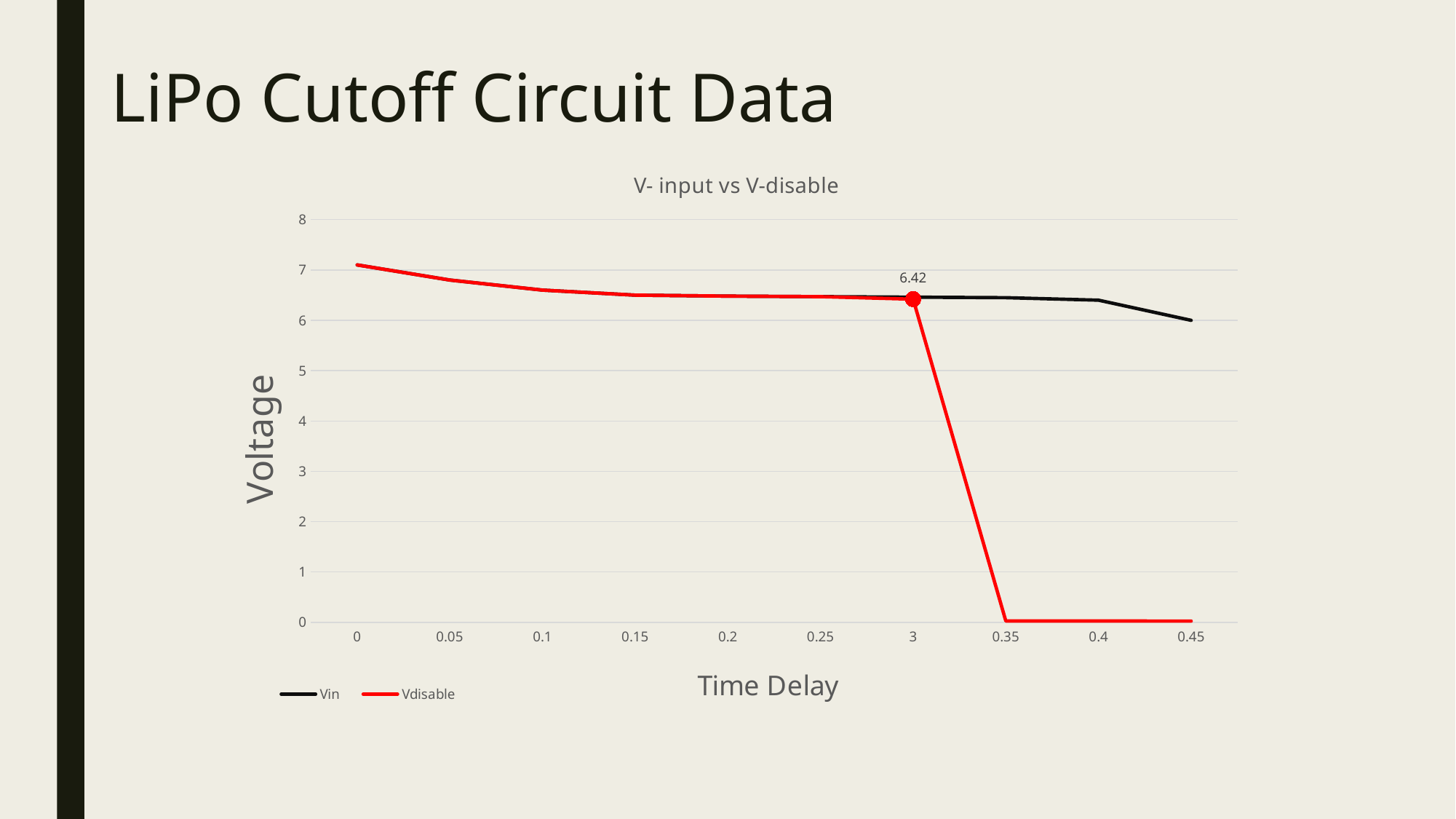
How many time delay points are plotted along the x axis? 10 Is the Vdisable value at time delay 0 greater or less than 7? greater Does the Vdisable line rise or fall along the x axis overall? fall How many series does the legend list? 2 Is the Vin value at time delay 0.45 greater or less than 5? greater What colour is the Vdisable line? red What value is labelled on the Vdisable line at time delay 3? 6.42 What kind of chart is shown on the slide? line chart What is the title of the chart? V- input vs V-disable At time delay 0.45, which series has the larger value, Vin or Vdisable? Vin